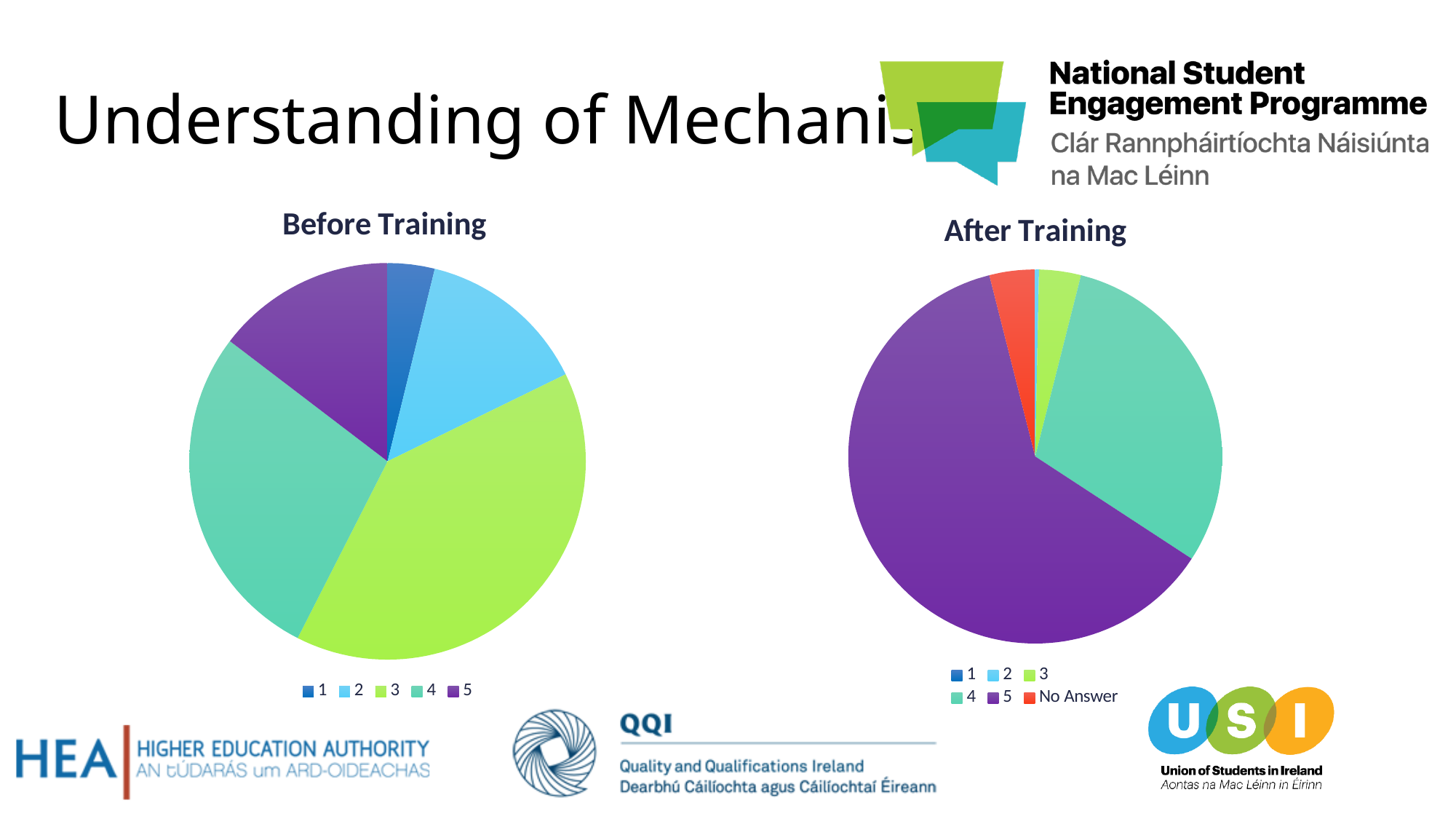
In the "Before Training" chart, which slice is larger, category 2 or category 4? 4 In the "After Training" chart, which category has the largest slice? 5 In the "Before Training" chart, which category has the smallest slice? 1 How many entries does the legend of the "After Training" chart list? 6 What kind of chart is the "After Training" chart? pie chart In the "After Training" chart, which slice is larger, category 4 or category 5? 5 Which legend entry appears in the "After Training" chart but not in the "Before Training" chart? No Answer In the "Before Training" chart, which slice is larger, category 3 or category 4? 3 How many entries does the legend of the "Before Training" chart list? 5 What kind of chart is the "Before Training" chart? pie chart In the "Before Training" chart, which category has the largest slice? 3